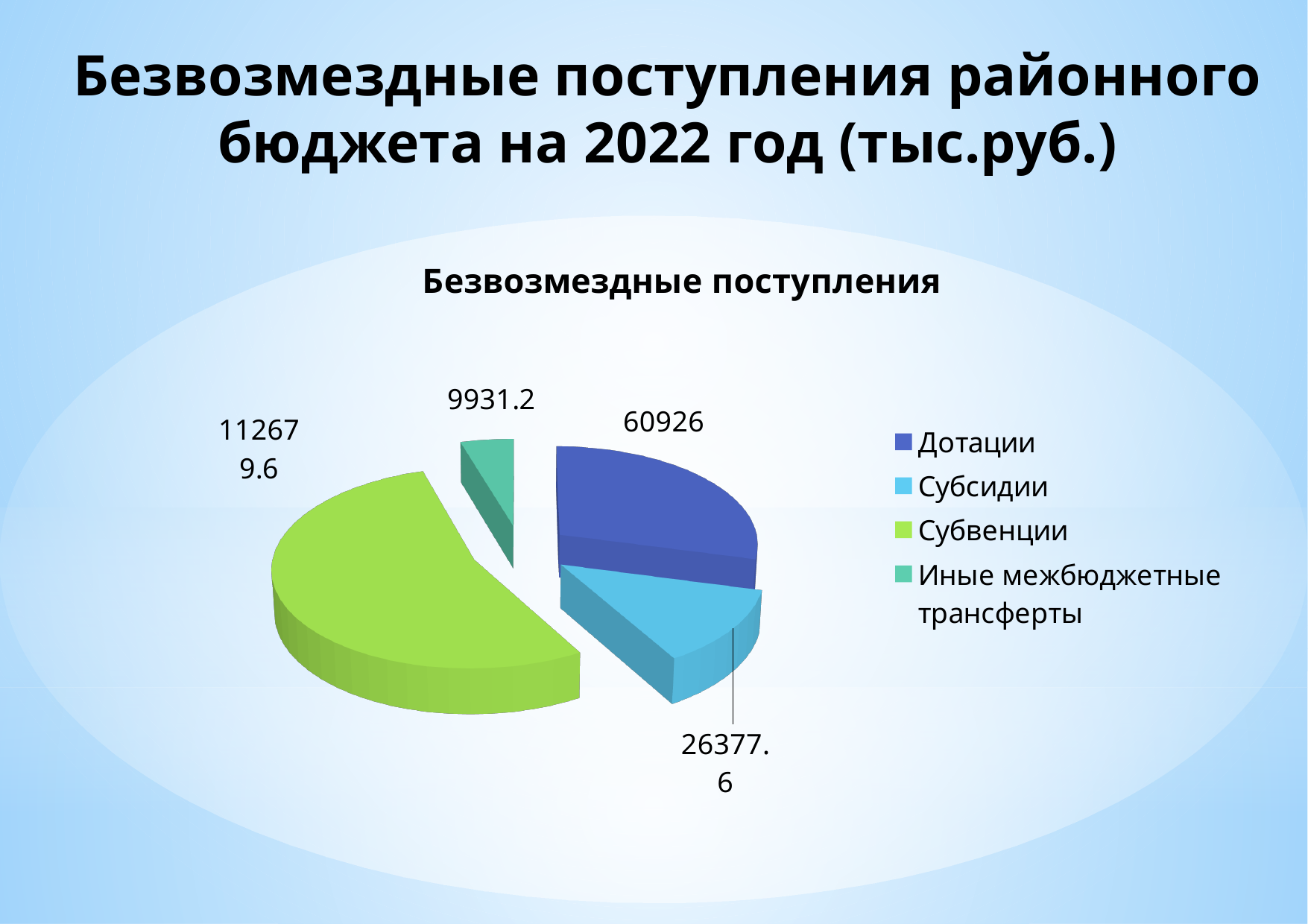
Which category has the smallest slice of the pie? Иные межбюджетные трансферты What type of chart is shown on the slide? pie chart What is the value for Субвенции? 112679.6 What is the title of the chart? Безвозмездные поступления What is the value for Дотации? 60926 What is the value for Субсидии? 26377.6 What is the value for Иные межбюджетные трансферты? 9931.2 What is the difference between the values for Субвенции and Дотации? 51753.6 Which is larger, the value for Субсидии or the value for Иные межбюджетные трансферты? Субсидии How many categories does the pie chart have? 4 Which category has the largest slice of the pie? Субвенции What is the difference between the values for Дотации and Субсидии? 34548.4